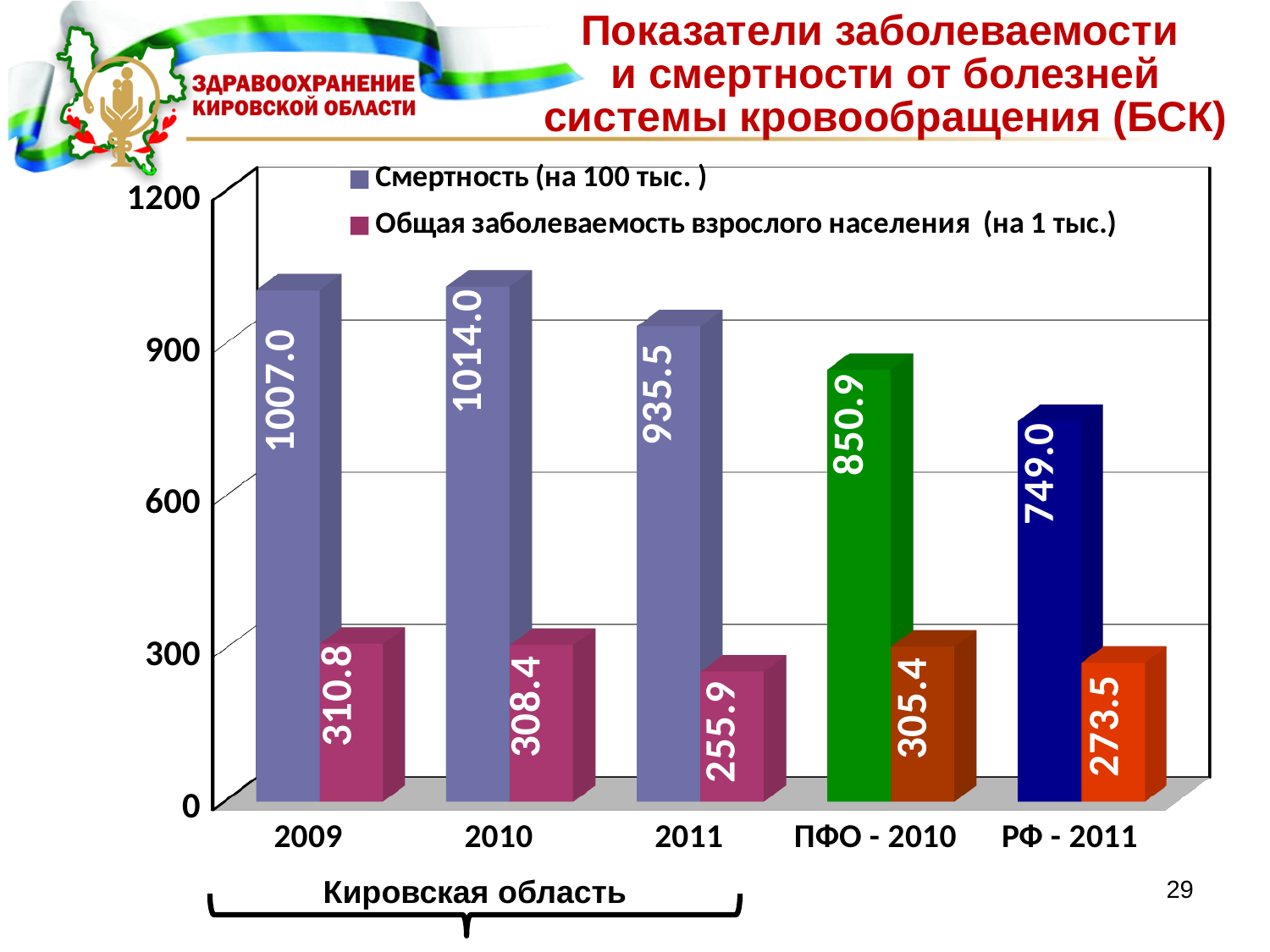
How many categories are shown on the x axis? 5 What is the value of Общая заболеваемость взрослого населения (на 1 тыс.) for 2011? 255.9 Which is larger: Смертность (на 100 тыс.) for ПФО - 2010 or for РФ - 2011? ПФО - 2010 What is the difference between the Смертность (на 100 тыс.) values for 2010 and 2011? 78.5 Which category has the highest value of Смертность (на 100 тыс.)? 2010 What kind of chart is shown on the slide? Bar chart What is the value of Смертность (на 100 тыс.) for РФ - 2011? 749.0 What is the value of Смертность (на 100 тыс.) for 2009? 1007.0 How many series does the legend list? 2 Does the Смертность (на 100 тыс.) value rise or fall from 2010 to 2011? Fall What is the value of Общая заболеваемость взрослого населения (на 1 тыс.) for ПФО - 2010? 305.4 Which category has the lowest value of Общая заболеваемость взрослого населения (на 1 тыс.)? 2011